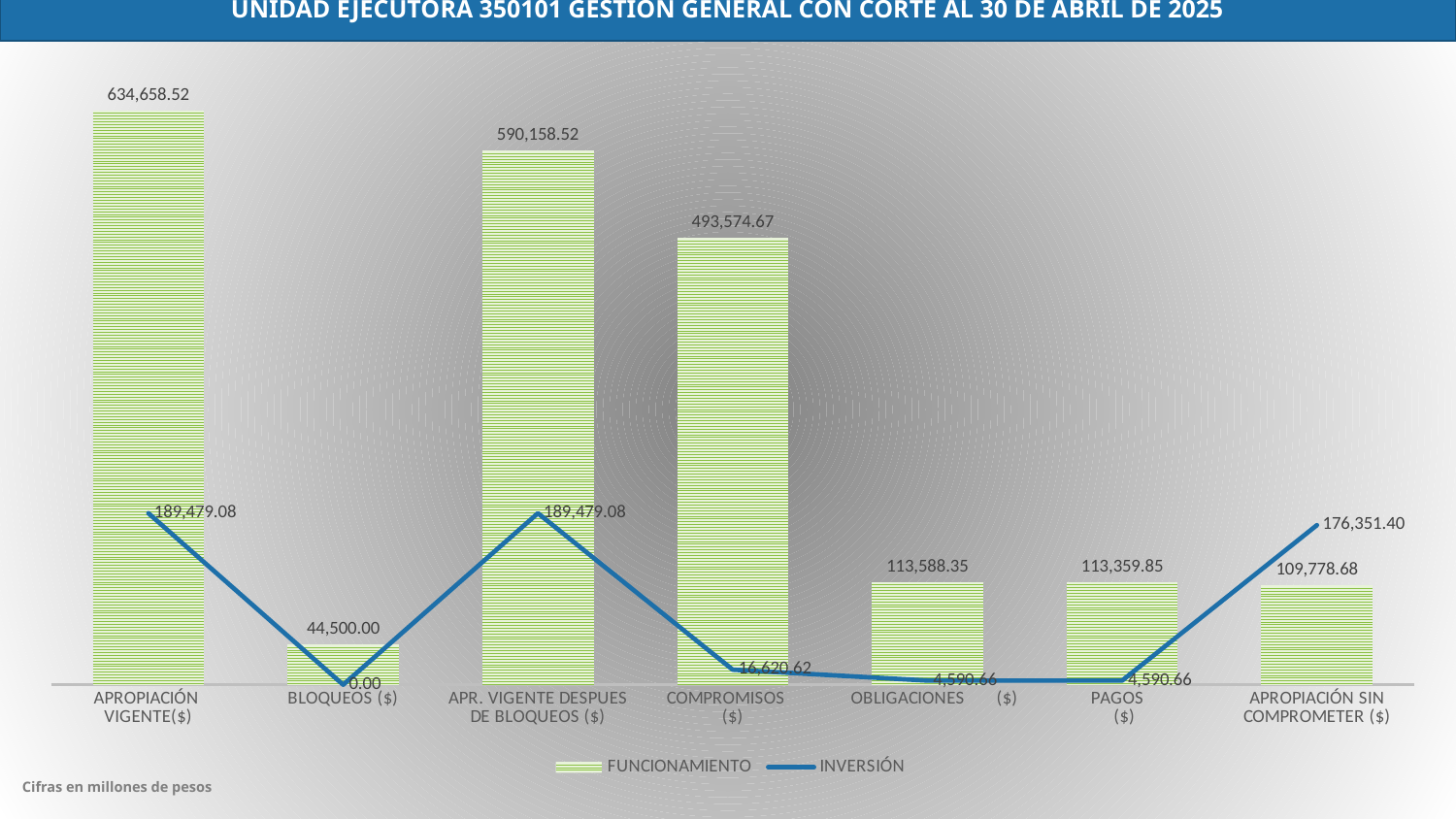
Which category has the highest FUNCIONAMIENTO value? APROPIACIÓN VIGENTE($) How many categories are shown on the x axis? 7 How many series does the legend list? 2 What is the difference between the FUNCIONAMIENTO values for COMPROMISOS ($) and OBLIGACIONES ($)? 379,986.32 What is the FUNCIONAMIENTO value for COMPROMISOS ($)? 493,574.67 Which has the larger FUNCIONAMIENTO value, OBLIGACIONES ($) or PAGOS ($)? OBLIGACIONES ($) What is the INVERSIÓN value for APROPIACIÓN SIN COMPROMETER ($)? 176,351.40 What is the FUNCIONAMIENTO value for APROPIACIÓN VIGENTE($)? 634,658.52 What is the difference between the FUNCIONAMIENTO values for APROPIACIÓN VIGENTE($) and APR. VIGENTE DESPUES DE BLOQUEOS ($)? 44,500.00 Which category has the lowest FUNCIONAMIENTO value? BLOQUEOS ($) What is the INVERSIÓN value for BLOQUEOS ($)? 0.00 What kind of chart is shown on the slide? Combined bar and line chart